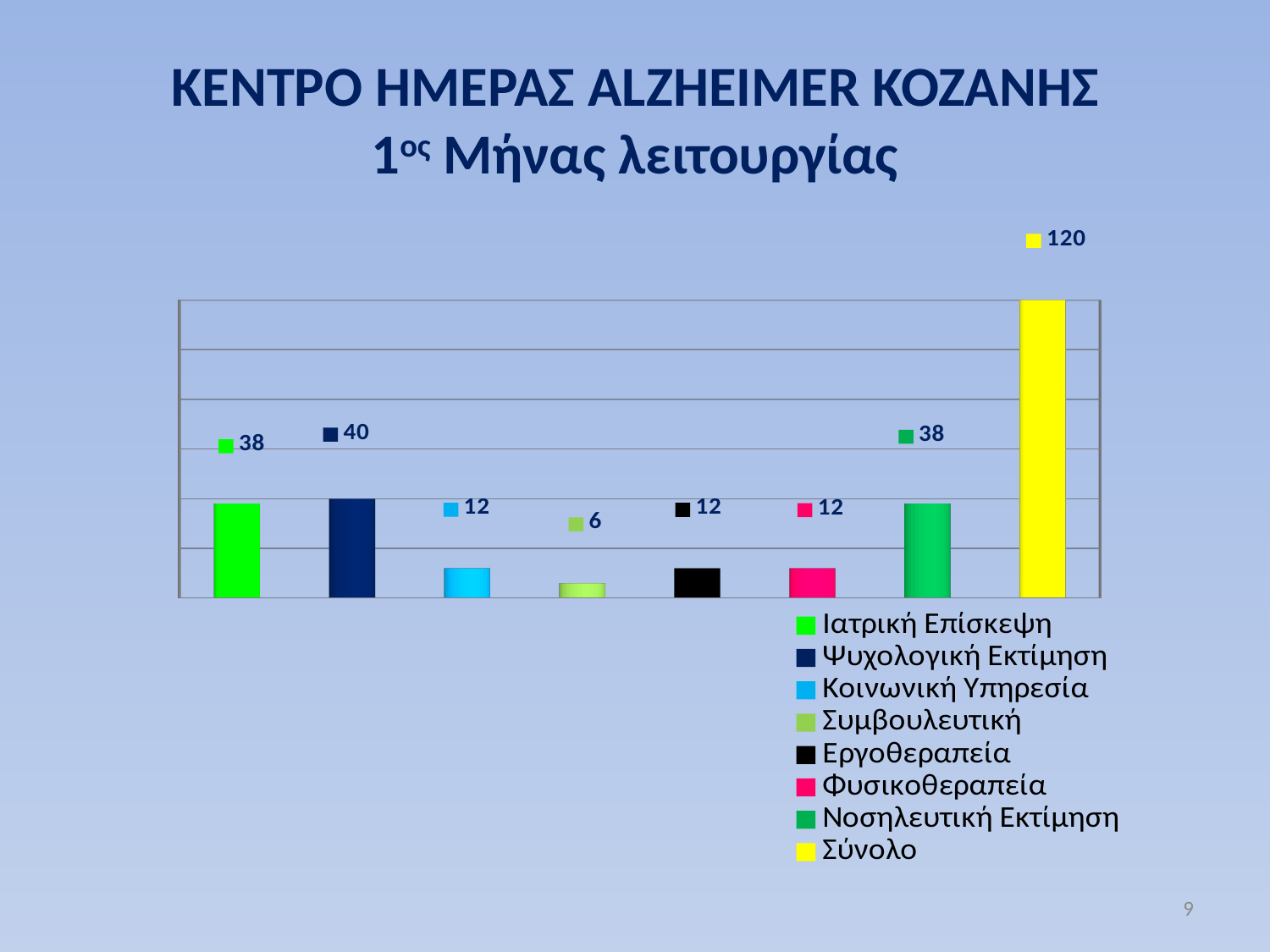
What value is shown for Ψυχολογική Εκτίμηση? 40 What value is shown for Συμβουλευτική? 6 What colour is the bar for Σύνολο? Yellow Which is larger, the value for Κοινωνική Υπηρεσία or the value for Συμβουλευτική? Κοινωνική Υπηρεσία What is the difference between the values for Ψυχολογική Εκτίμηση and Ιατρική Επίσκεψη? 2 What is the difference between the values for Σύνολο and Νοσηλευτική Εκτίμηση? 82 What value is shown for Νοσηλευτική Εκτίμηση? 38 Excluding Σύνολο, which service has the highest value? Ψυχολογική Εκτίμηση What kind of chart is shown on the slide? Bar chart Which service has the lowest value? Συμβουλευτική What value is shown for Σύνολο? 120 How many series does the legend list? 8